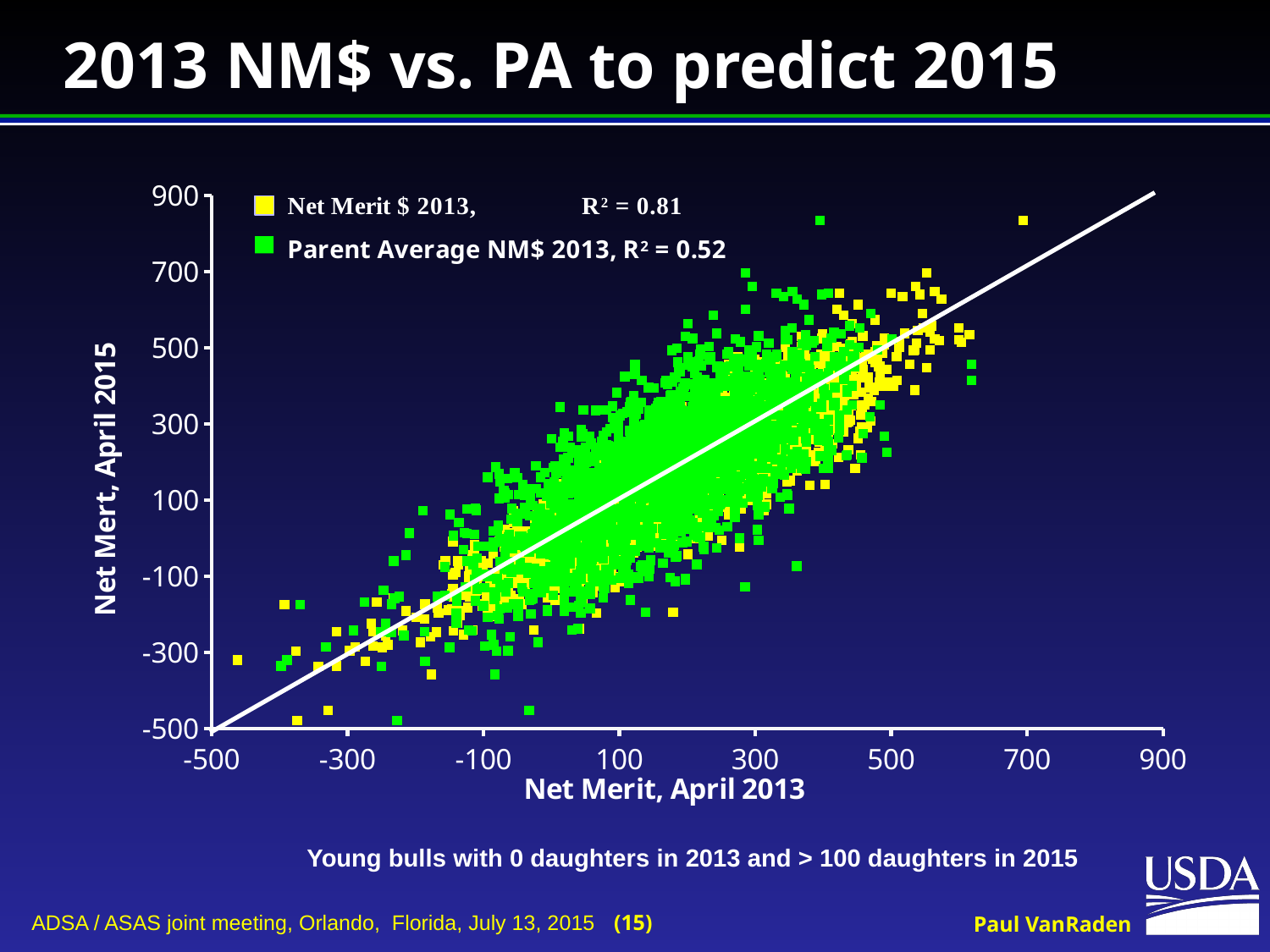
What is the R² value for the Parent Average NM$ 2013 series? 0.52 What kind of chart is shown on the slide? scatter plot What colour represents the Parent Average NM$ 2013 series? green How many series does the legend list? 2 What is the lowest tick value shown on the x axis? -500 What is the highest tick value shown on the y axis? 900 What is the label of the x axis? Net Merit, April 2013 What is the title of the chart? 2013 NM$ vs. PA to predict 2015 What is the R² value for the Net Merit $ 2013 series? 0.81 Do the plotted values generally rise or fall as Net Merit, April 2013 increases along the x axis? rise What is the difference between the R² values of the Net Merit $ 2013 and Parent Average NM$ 2013 series? 0.29 Which series has the higher R², Net Merit $ 2013 or Parent Average NM$ 2013? Net Merit $ 2013